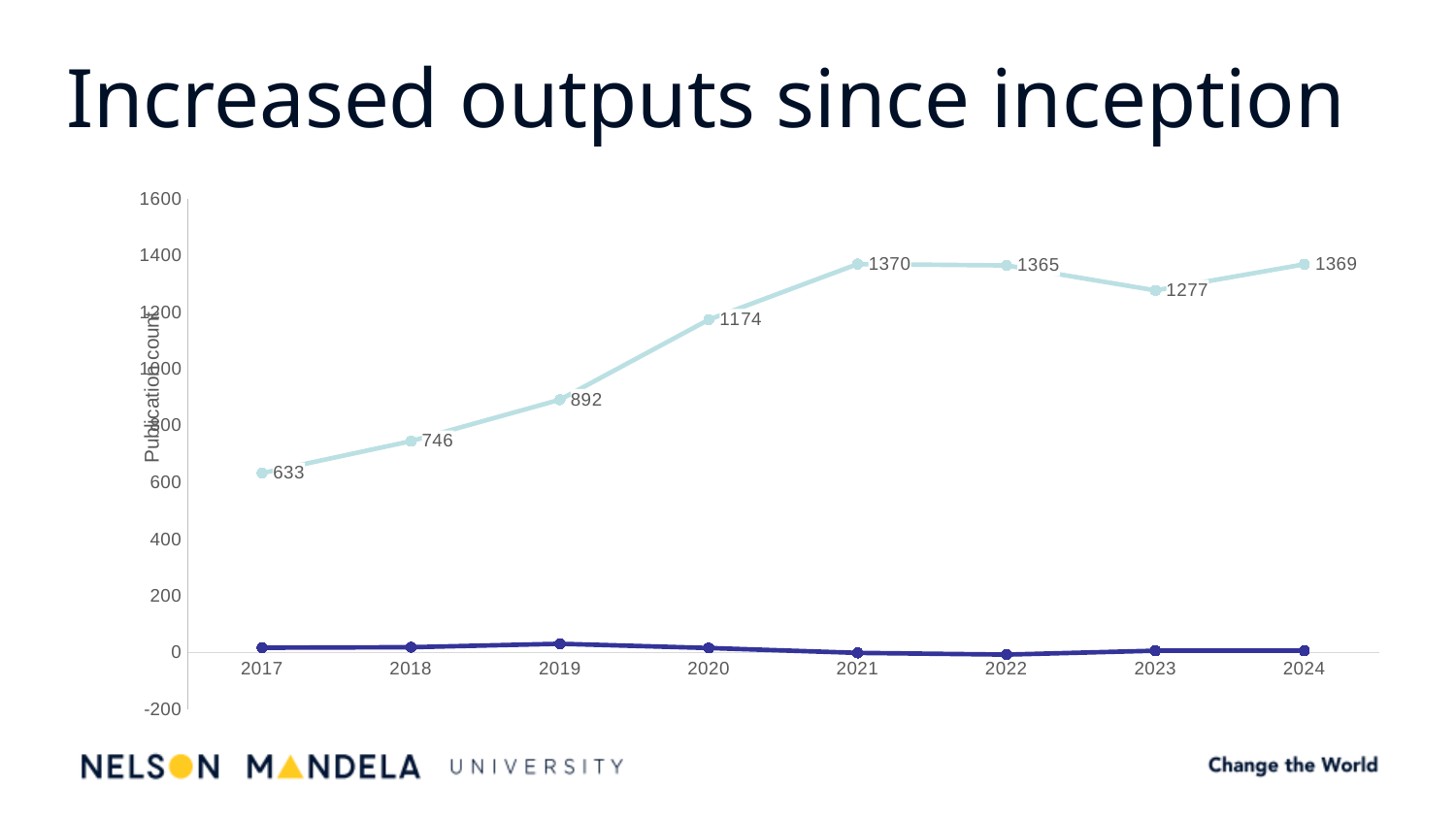
What is the difference between the light blue line's values for 2020 and 2019? 282 What is the difference between the light blue line's values for 2021 and 2017? 737 What kind of chart is shown on the slide? line chart What is the labelled value of the light blue line for 2023? 1277 Is the dark blue line's value for 2019 greater or less than 200? less What is the labelled value of the light blue line for 2024? 1369 Does the light blue line rise or fall from 2017 to 2021? rise On the light blue line, which year has the larger value, 2022 or 2023? 2022 What is the labelled value of the light blue line for 2020? 1174 How many years are shown on the x axis? 8 In which year is the light blue line at its lowest value? 2017 What is the labelled value of the light blue line for 2017? 633